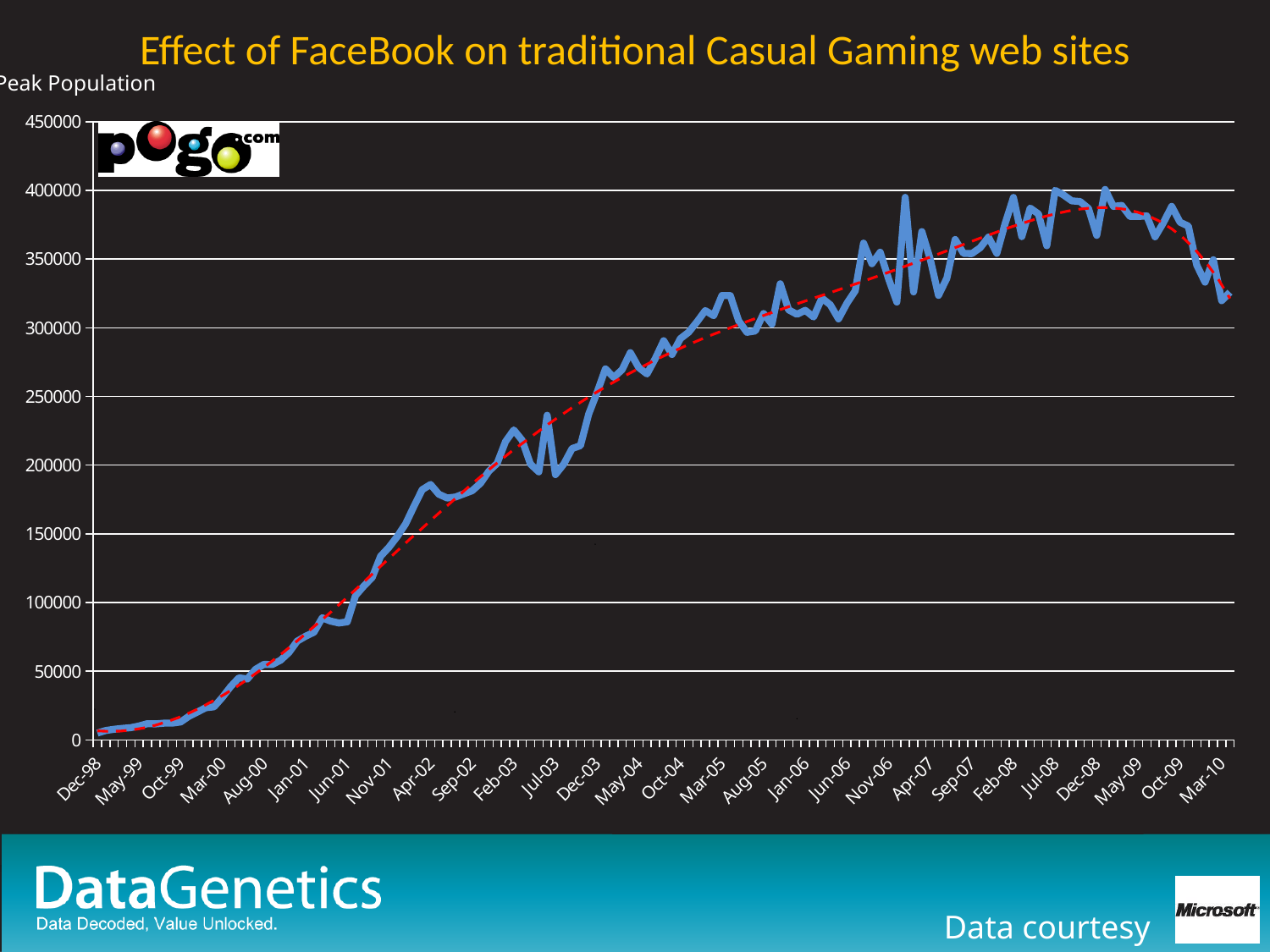
Is the value for Dec-98 greater or less than 50000? less What kind of chart is shown on the slide? line chart What is the label on the vertical axis of the chart? Peak Population Does the peak population rise or fall between Dec-98 and Feb-08? rise Is the value for Apr-02 greater or less than 150000? greater Is the value for Nov-01 greater or less than 100000? greater What is the title of the chart? Effect of FaceBook on traditional Casual Gaming web sites Does the peak population rise or fall between Jul-08 and Mar-10? fall Which x-axis label has the lowest peak population value? Dec-98